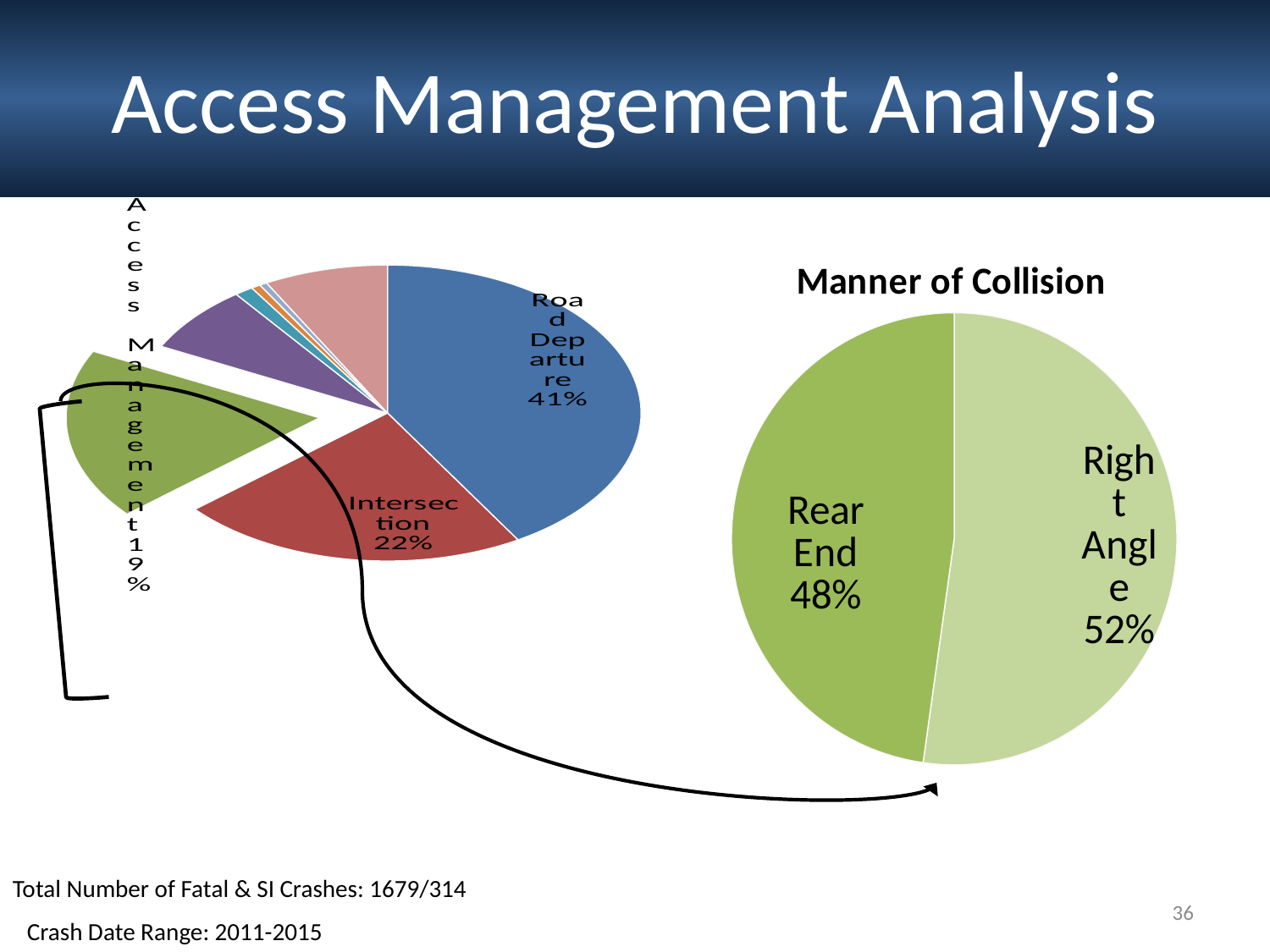
What type of chart is the Manner of Collision chart? Pie chart In the Manner of Collision chart, what share of collisions is Right Angle? 52% In the left pie chart, what percentage is labelled Access Management? 19% How many slices does the Manner of Collision pie chart have? 2 In the Manner of Collision chart, which category has the larger share? Right Angle In the Manner of Collision chart, what is the difference between the Right Angle and Rear End shares? 4% In the left pie chart, what is the difference between the Road Departure and Intersection shares? 19% In the Manner of Collision chart, what share of collisions is Rear End? 48% In the left pie chart, which labelled category has the largest share? Road Departure In the left pie chart, what percentage is labelled Road Departure? 41% What is the title of the pie chart on the right? Manner of Collision In the left pie chart, what percentage is labelled Intersection? 22%